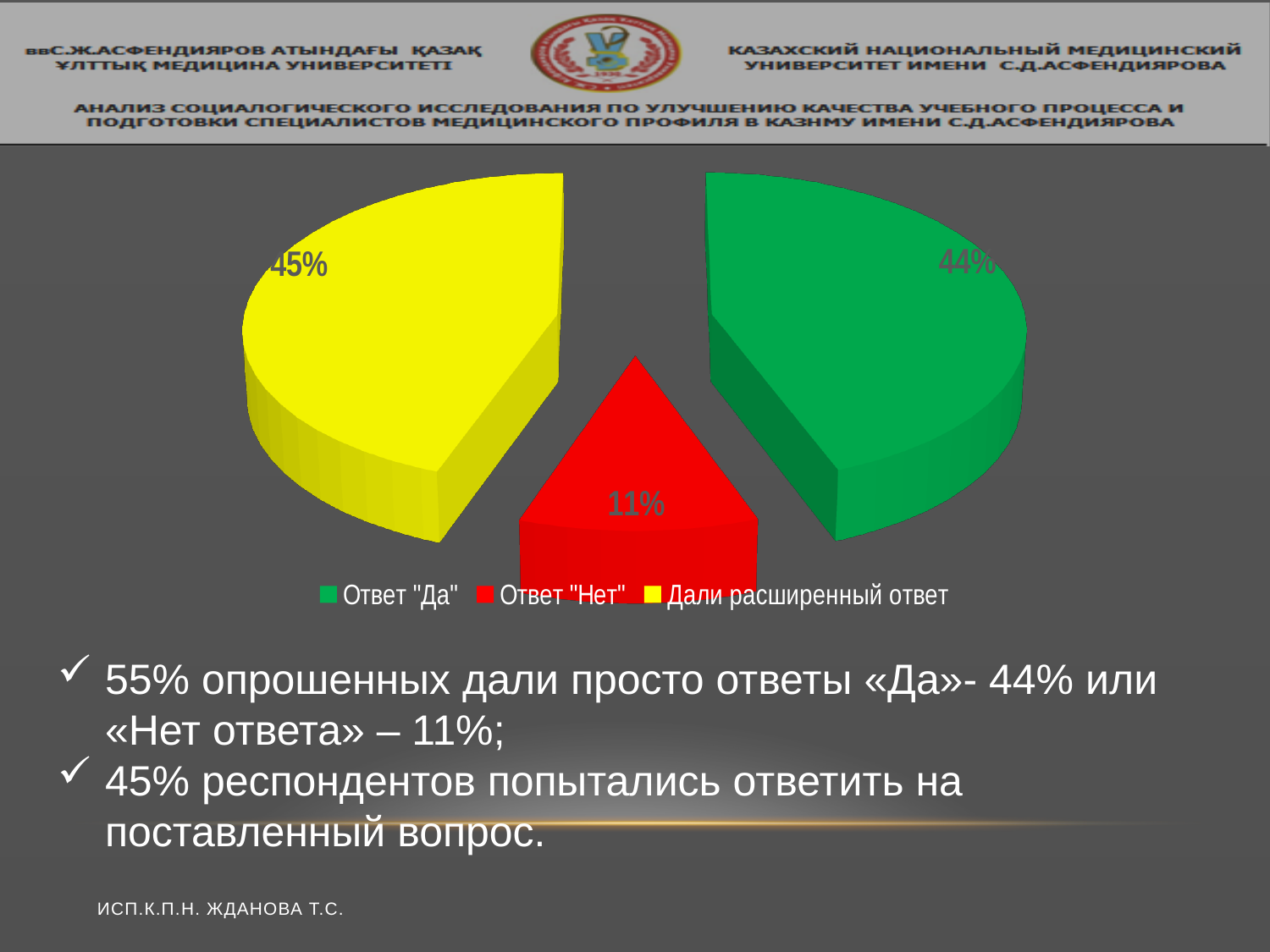
How many entries does the legend of the pie chart list? 3 What colour is the slice for Ответ "Нет" in the pie chart? red Which is larger, the Ответ "Да" slice or the Ответ "Нет" slice? Ответ "Да" Which slice of the pie chart is the smallest? Ответ "Нет" What is the difference between the Ответ "Да" slice and the Ответ "Нет" slice? 33% What percentage is shown for the slice labelled Дали расширенный ответ? 45% How many slices does the pie chart have? 3 What percentage is shown for the slice labelled Ответ "Да"? 44% What kind of chart is shown on the slide? pie chart What percentage is shown for the slice labelled Ответ "Нет"? 11% What colour is the slice for Дали расширенный ответ in the pie chart? yellow What is the combined share of the Ответ "Да" and Ответ "Нет" slices? 55%